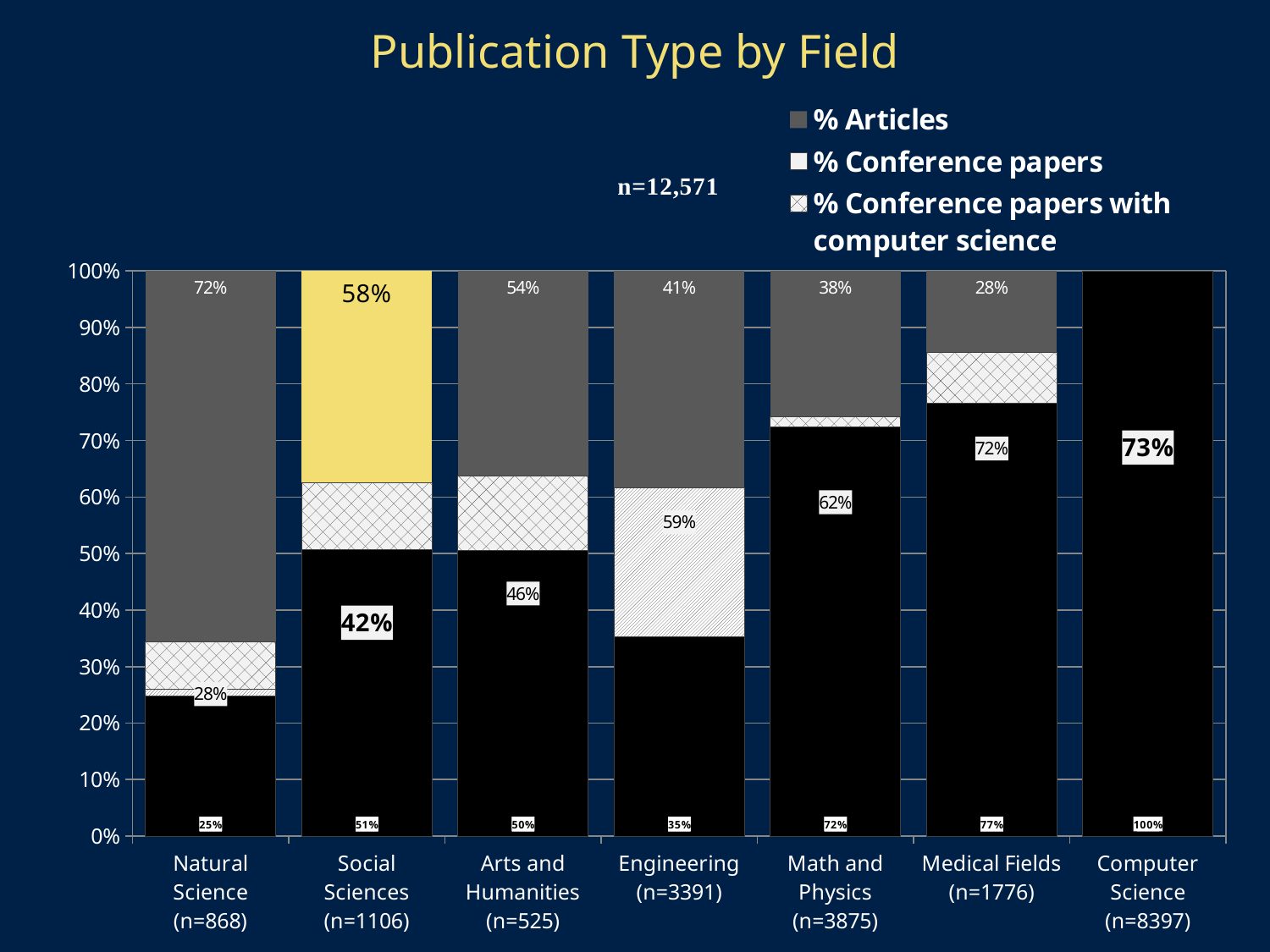
How many series does the legend list? 3 What total sample size (n) is printed on the slide? n=12,571 How many fields (categories) are shown along the x axis? 7 Which field has the highest % Articles? Natural Science What is the difference in % Articles between Natural Science and Medical Fields? 44 percentage points What is the % Articles value for Engineering? 41% What is the % Articles value for Natural Science? 72% Which has a higher % Articles value, Social Sciences or Arts and Humanities? Social Sciences Does the % Articles value rise or fall moving from Natural Science to Medical Fields along the x axis? Fall What kind of chart is shown on the slide? Stacked bar chart